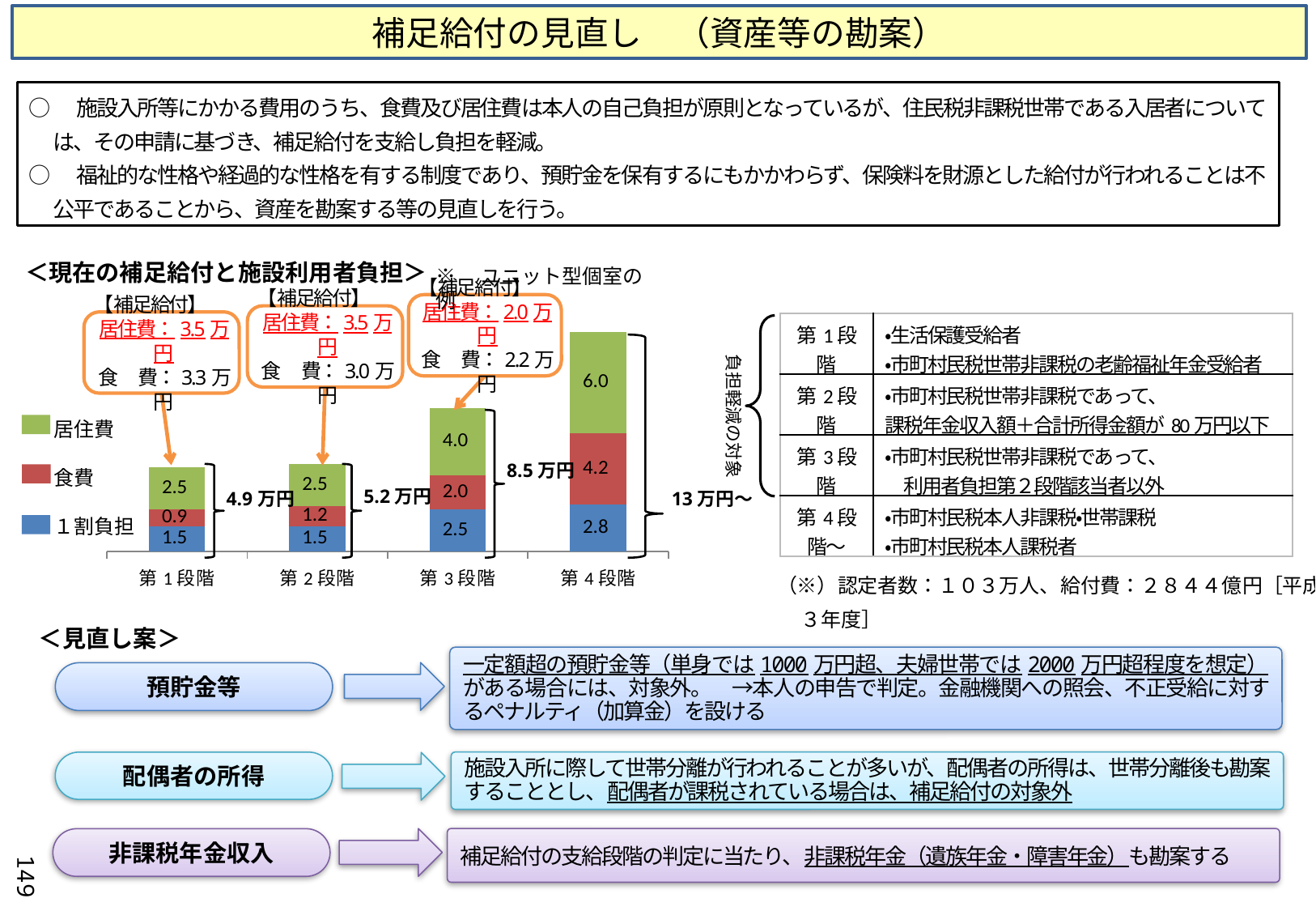
What type of chart is shown under ＜現在の補足給付と施設利用者負担＞? stacked bar chart How many series does the legend of the bar chart list? 3 What is the total labelled for the 第２段階 stacked bar? 5.2万円 Is the 居住費 value larger for 第３段階 or 第２段階? 第３段階 What is the 食費 value for 第１段階 in the bar chart? 0.9 What is the difference between the 食費 values for 第４段階 and 第３段階? 2.2 What is the １割負担 value for 第４段階 in the bar chart? 2.8 What is the 居住費 value for 第３段階 in the bar chart? 4.0 How many categories (段階) are shown on the x axis of the bar chart? 4 Which 段階 has the highest 居住費 value in the bar chart? 第４段階 Do the stacked bar totals rise or fall from 第１段階 to 第４段階? rise Which 段階 has the lowest 食費 value in the bar chart? 第１段階